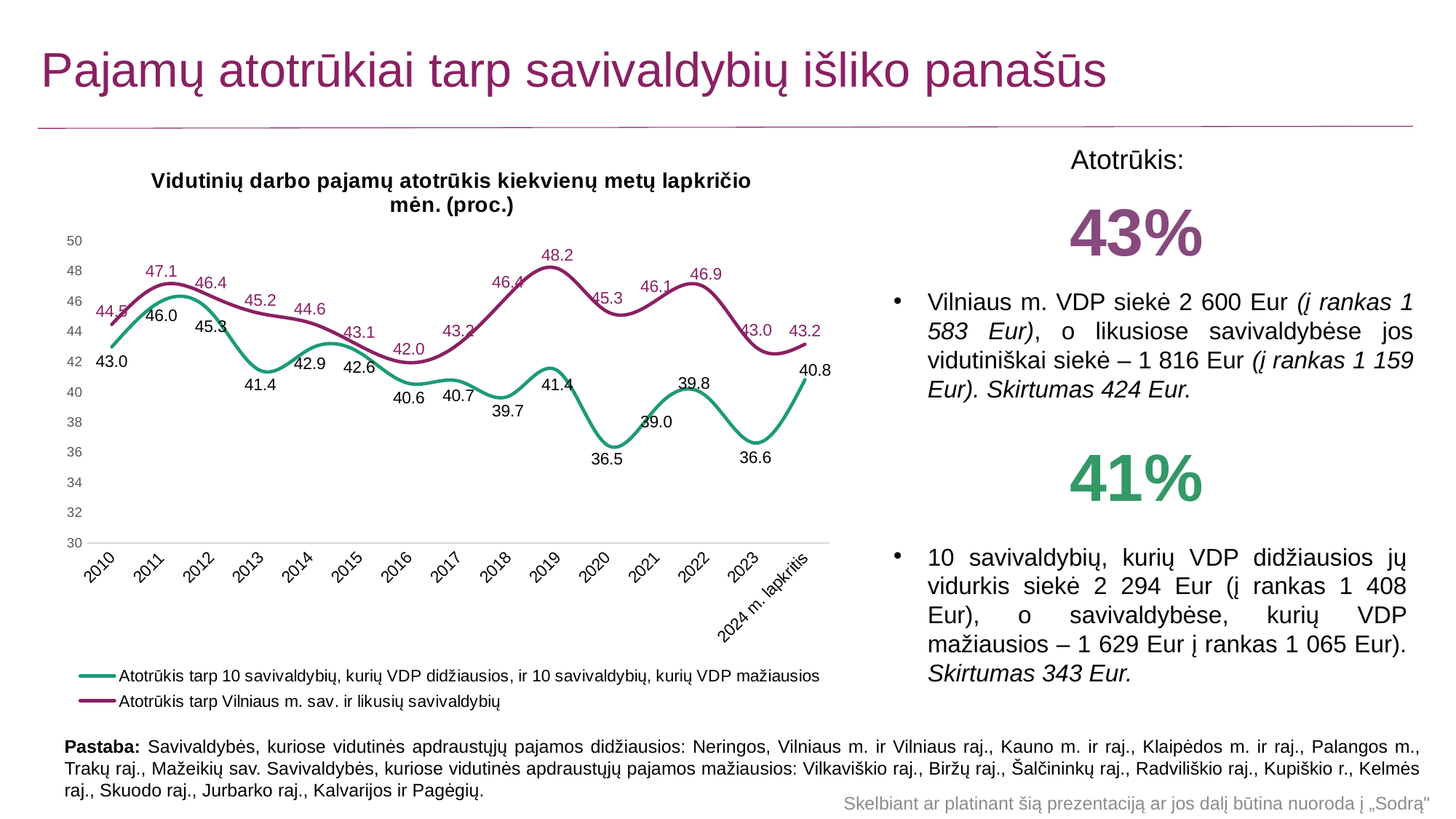
What is the value of the purple series (Atotrūkis tarp Vilniaus m. sav. ir likusių savivaldybių) in 2019? 48.2 In which year does the purple series (Vilniaus m. sav. vs likusios savivaldybės) reach its highest value? 2019 What is the difference between the purple and green series values for 2024 m. lapkritis? 2.4 In which year is the purple series at its lowest value? 2016 Which series has the higher value in 2013: the purple (Vilniaus m. sav.) or the green (10 savivaldybių)? Purple (Atotrūkis tarp Vilniaus m. sav. ir likusių savivaldybių) What is the value of the green series (Atotrūkis tarp 10 savivaldybių, kurių VDP didžiausios, ir 10 savivaldybių, kurių VDP mažiausios) in 2020? 36.5 In which year does the green series (10 savivaldybių) reach its lowest value? 2020 How many data points (years) are plotted on the x axis? 15 What is the difference between the purple and green series values in 2020? 8.8 How many series does the legend list? 2 What is the value of the green series for 2024 m. lapkritis? 40.8 What type of chart is shown on the slide? Line chart